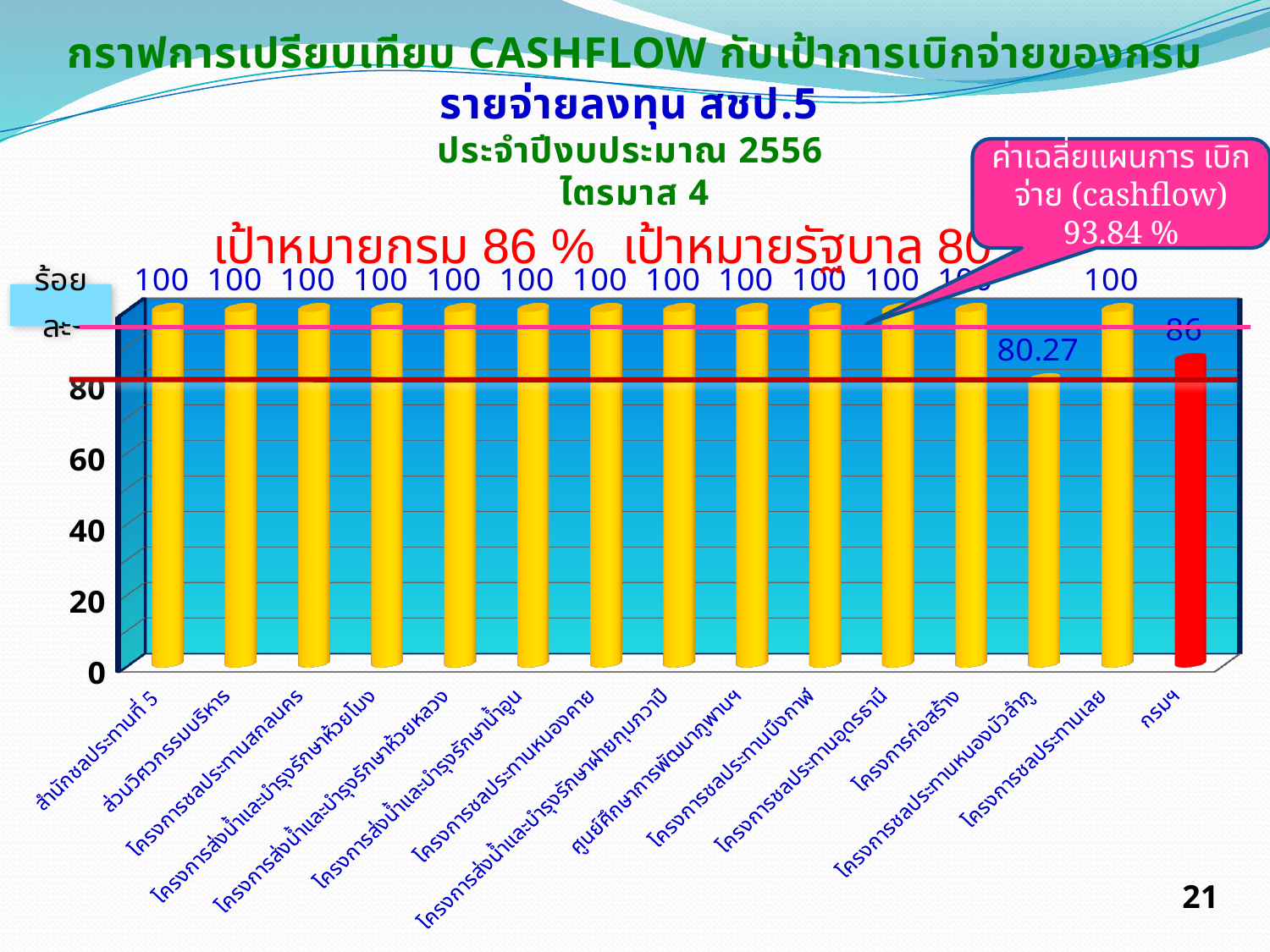
What is the difference between the value for กรมฯ and the value for โครงการชลประทานหนองบัวลำภู? 5.73 What is the value for สำนักชลประทานที่ 5? 100 What is the value for โครงการชลประทานเลย? 100 What is the difference between the value for โครงการชลประทานเลย and the value for โครงการชลประทานหนองบัวลำภู? 19.73 How many categories are shown on the x axis? 15 Which category has the lowest value? โครงการชลประทานหนองบัวลำภู What is the value for โครงการชลประทานหนองบัวลำภู? 80.27 Which is larger, the value for กรมฯ or the value for โครงการชลประทานหนองบัวลำภู? กรมฯ What colour is the bar for กรมฯ? red What kind of chart is shown on the slide? bar chart Is the value for โครงการชลประทานหนองบัวลำภู greater or less than 60? greater What is the value for กรมฯ? 86